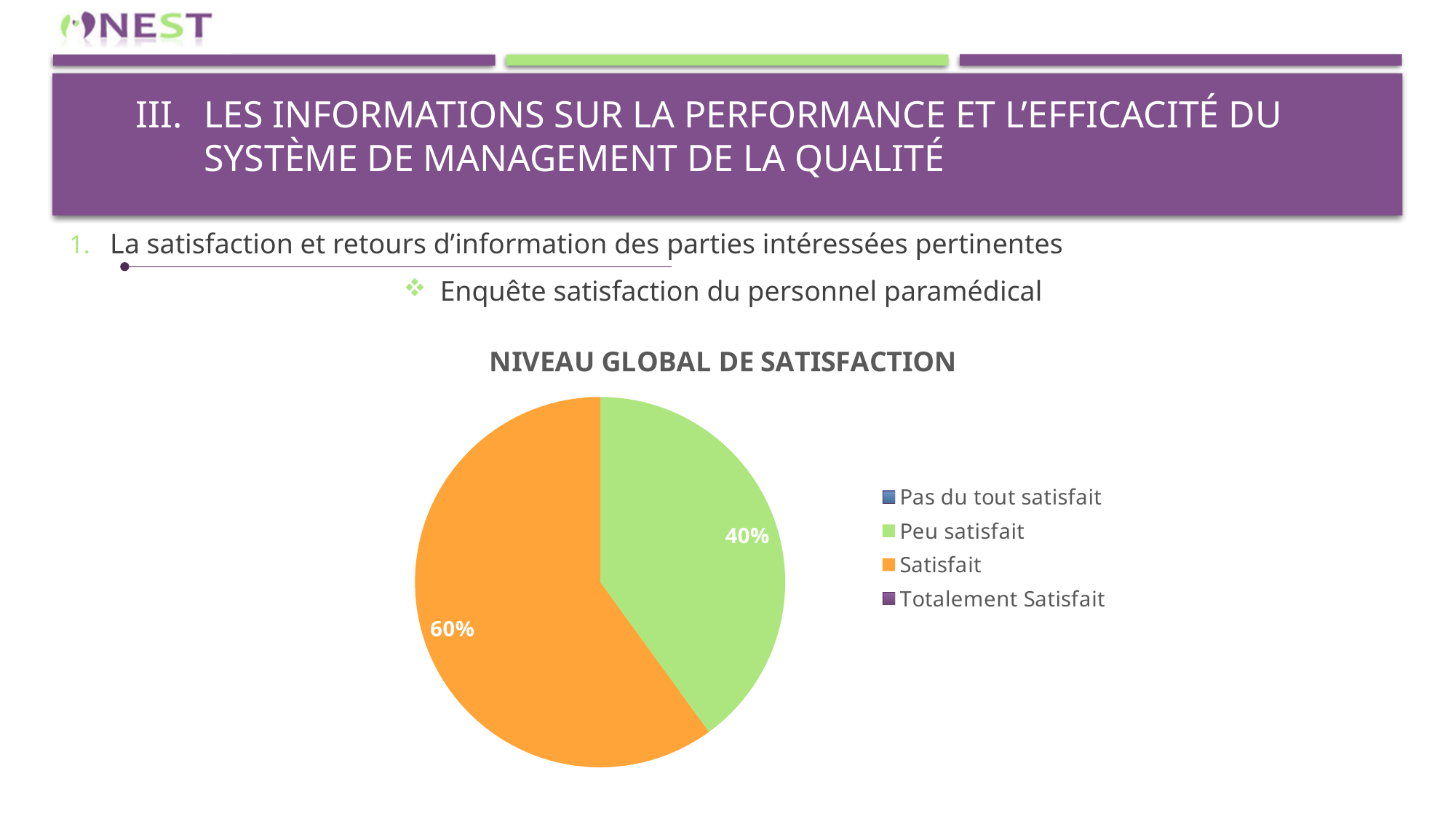
Which of the two visible slices is larger, 'Satisfait' or 'Peu satisfait'? Satisfait What is the difference in percentage points between the 'Satisfait' and 'Peu satisfait' slices? 20% How many slices are visible in the pie? 2 What percentage of the pie is labelled for 'Satisfait'? 60% What colour is the 'Satisfait' slice? orange How many entries does the legend list? 4 What is the combined share of the 'Satisfait' and 'Peu satisfait' slices? 100% Which category has the largest share of the pie? Satisfait What percentage of the pie is labelled for 'Peu satisfait'? 40% What is the title of the chart? NIVEAU GLOBAL DE SATISFACTION What kind of chart is shown on the slide? pie chart